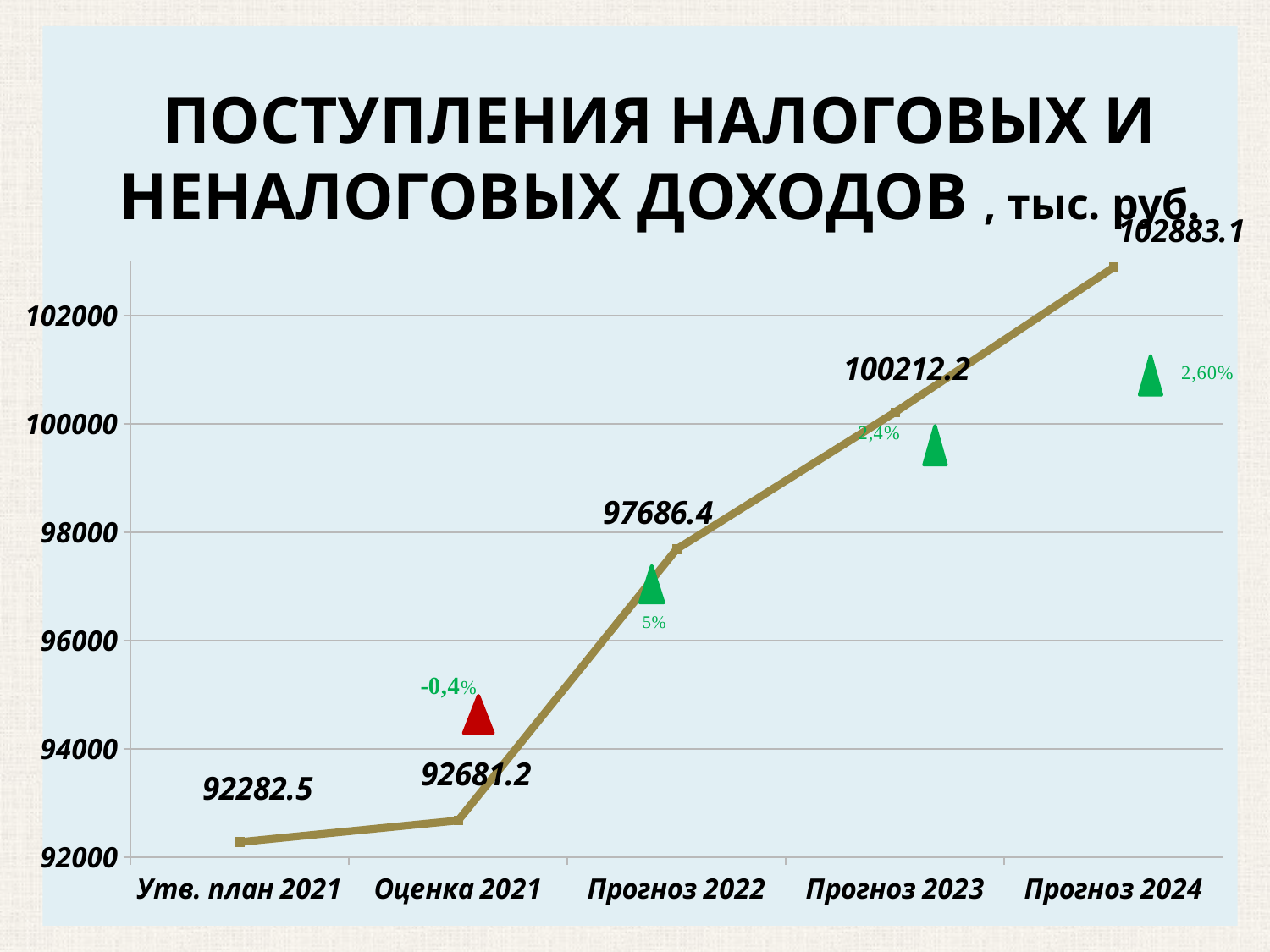
What is the value for Прогноз 2022? 97686.4 Do the values rise or fall from Утв. план 2021 to Прогноз 2024? rise Which category has the highest value? Прогноз 2024 What is the value for Прогноз 2023? 100212.2 What is the value for Прогноз 2024? 102883.1 How many categories are plotted on the x axis? 5 What is the value for Оценка 2021? 92681.2 What is the difference between the values for Прогноз 2022 and Оценка 2021? 5005.2 What type of chart is shown on the slide? line chart What is the value for Утв. план 2021? 92282.5 Which is larger, the value for Прогноз 2023 or the value for Прогноз 2022? Прогноз 2023 Which category has the lowest value? Утв. план 2021